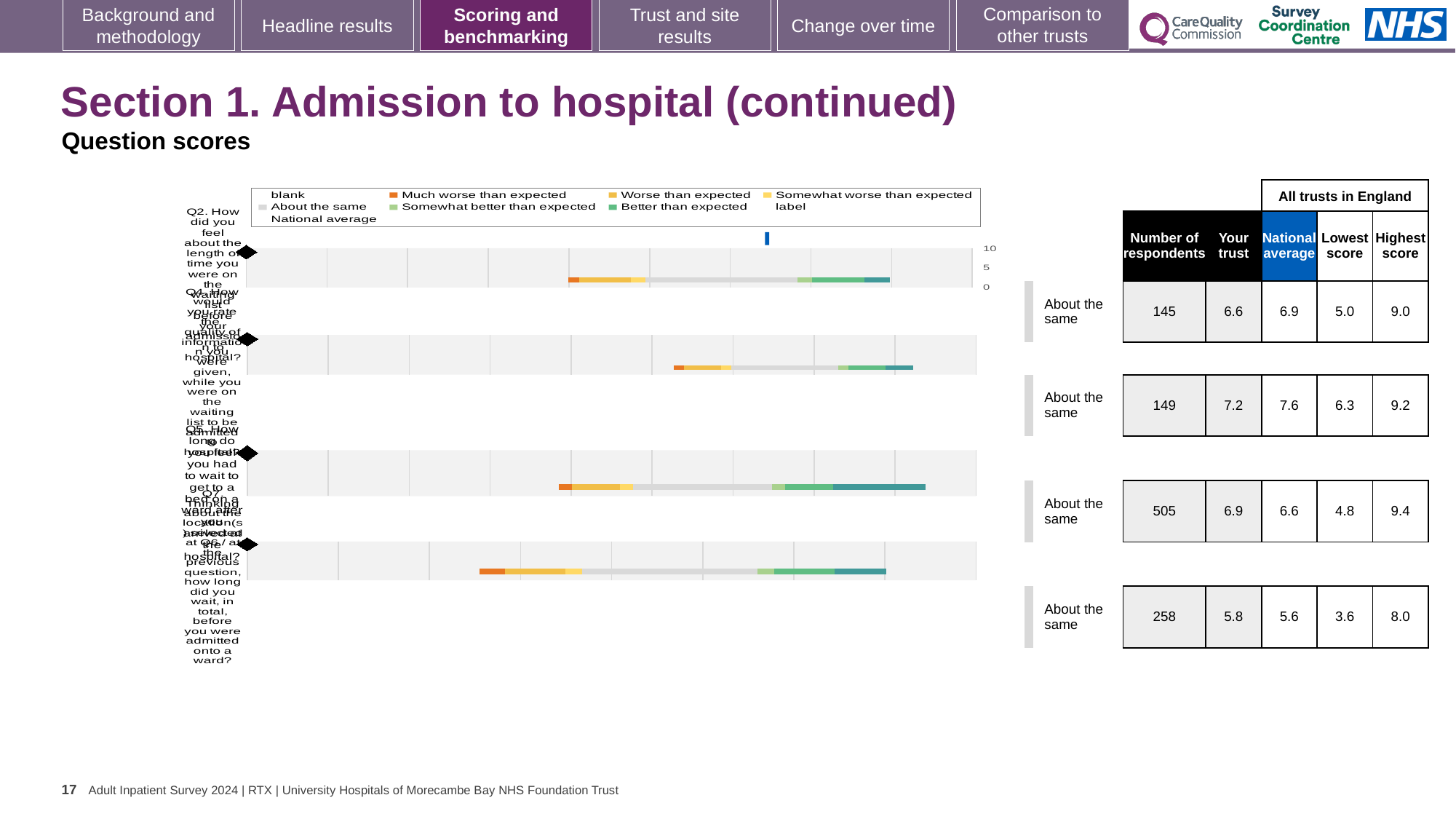
In the table, what is the 'Your trust' score in the second row? 7.2 How many horizontal bars are plotted in the chart? 4 What is the highest value shown on the chart's numeric axis? 10 Which legend entry is shown in dark orange? Much worse than expected In the table's first row, which is larger: the 'Your trust' score or the 'National average'? National average In the table, what is the number of respondents in the first row? 145 What benchmark label is shown beside each of the four rows? About the same In the table's first row, what is the difference between the National average (6.9) and the Your trust score (6.6)? 0.3 What kind of chart is shown on the slide? bar chart In the table, what is the highest score in the fourth row? 8.0 In the table, what is the lowest 'Your trust' score shown? 5.8 In the table, which row has the highest number of respondents? third row (505)